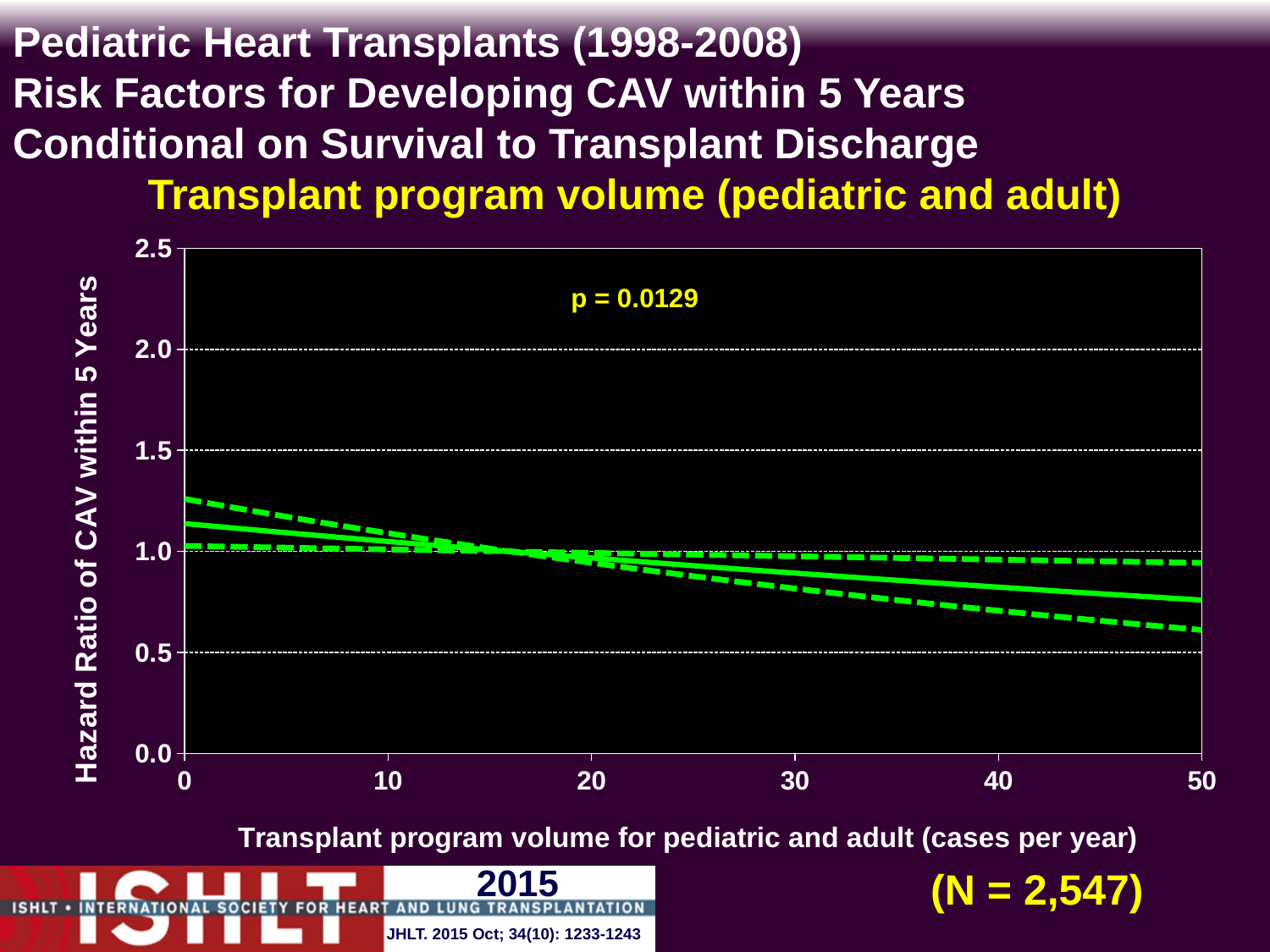
How many lines are plotted on the chart? 3 What p-value is printed on the chart? p = 0.0129 Is the lower dashed line at a program volume of 50 cases per year greater or less than 0.5? greater Does the solid hazard ratio line rise or fall as transplant program volume increases from 0 to 50 cases per year? fall Is the solid line value at a program volume of 50 cases per year greater or less than 0.5? greater Is the hazard ratio on the solid line at a program volume of 0 cases per year greater or less than 1.0? greater What kind of chart is shown on the slide? line chart What is the maximum value shown on the y axis of the chart? 2.5